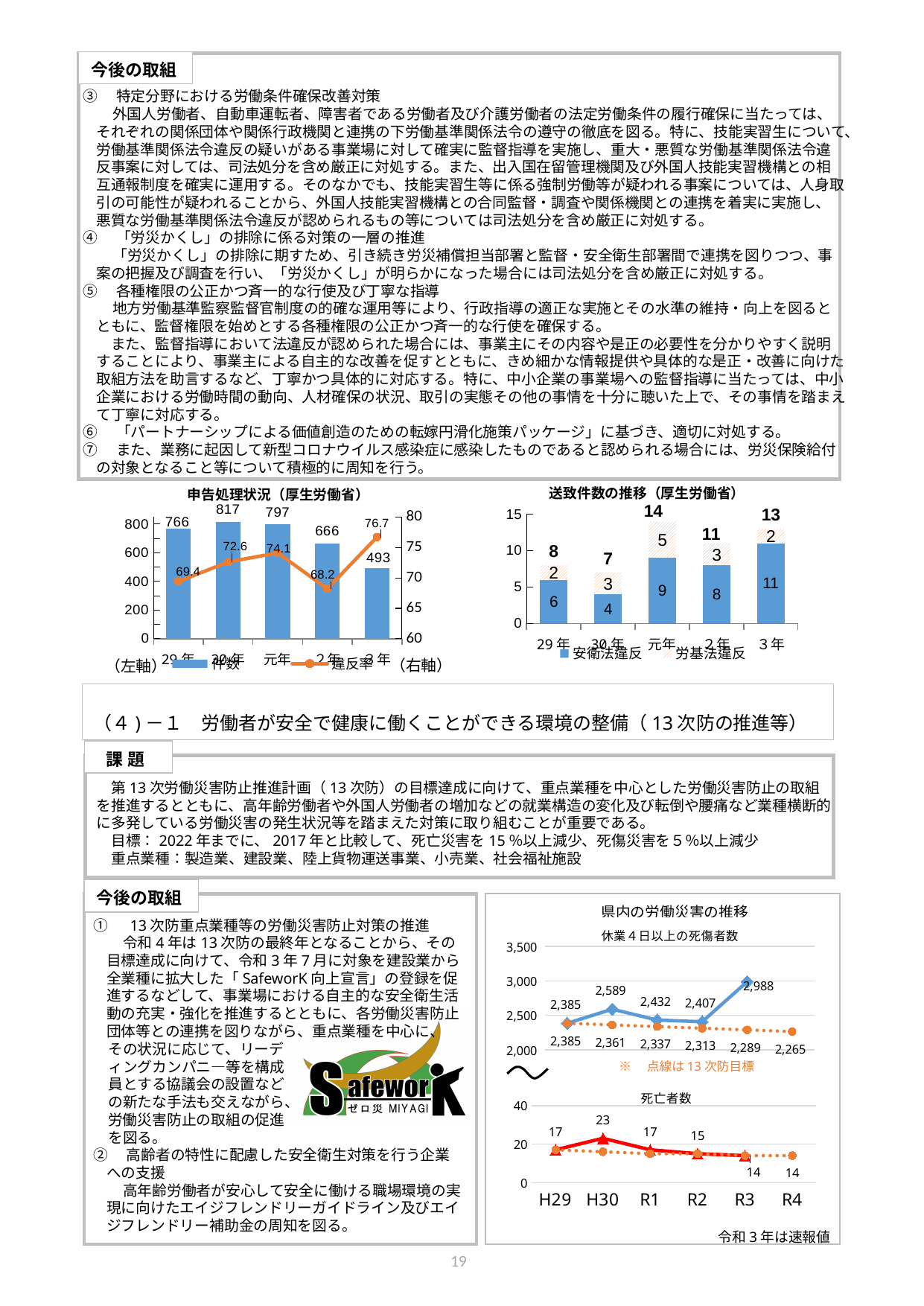
How many series does the legend of the 送致件数の推移 chart list? 2 In the 申告処理状況 chart, what is the 件数 value for 30年? 817 In the 申告処理状況 chart, what is the difference in 件数 between 29年 and 2年? 100 In the 県内の労働災害の推移 chart, which year has the highest 死亡者数? H30 In the 県内の労働災害の推移 chart, what is the 休業4日以上の死傷者数 value for R3? 2,988 In the 県内の労働災害の推移 chart, is the 休業4日以上の死傷者数 value for H30 larger than the value for R2? Yes What kind of chart is the 送致件数の推移 chart? stacked bar chart In the 送致件数の推移 chart, what is the total for 元年? 14 In the 申告処理状況 chart, what is the 違反率 value for 3年? 76.7 In the 送致件数の推移 chart, what is the 安衛法違反 value for 3年? 11 In the 申告処理状況 chart, which year has the lowest 件数? 3年 In the 送致件数の推移 chart, which year has the lowest total? 30年